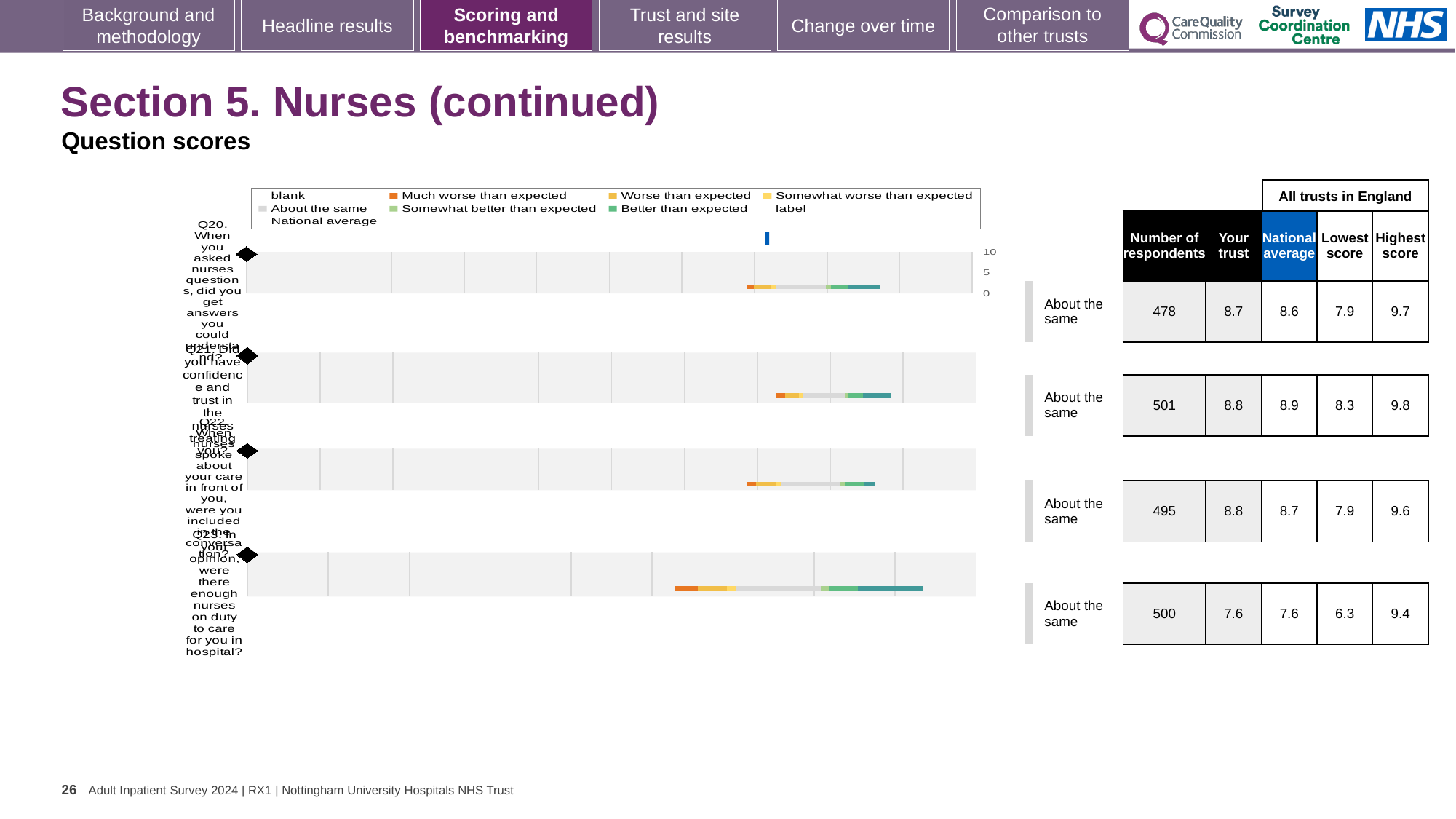
What colour represents 'Much worse than expected' in the chart legend? Orange For Q21, which is larger: the 'Your trust' score or the national average? National average What benchmark category is shown for each of the four questions on the slide? About the same How many questions (bars) are plotted in the chart? 4 According to the table beside the chart, what is the national average for Q22? 8.7 According to the table beside the chart, what is the 'Your trust' score for Q23? 7.6 Which question has the highest 'Highest score' value in the table beside the chart? Q21 Which question has the lowest 'Your trust' score in the table beside the chart? Q23 How many entries does the chart legend list? 9 According to the table beside the chart, how many respondents answered Q20? 478 What kind of chart is shown on the slide? Bar chart For Q20, what is the difference between the highest score and the lowest score across all trusts in England? 1.8